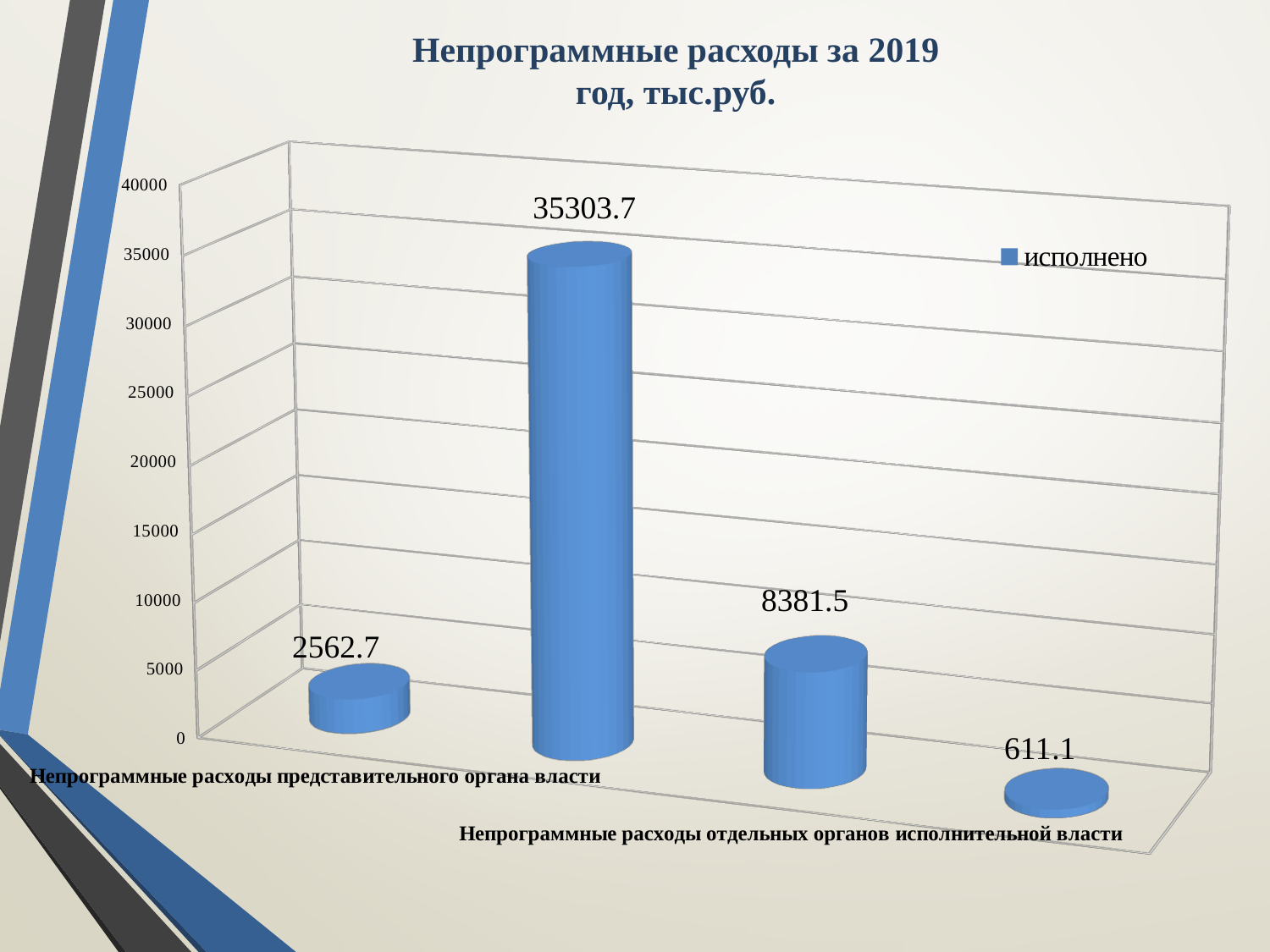
What is the name of the series in the legend? исполнено What is the value of the tallest bar in the chart? 35303.7 What is the value of the shortest bar in the chart? 611.1 What is the title of the chart? Непрограммные расходы за 2019 год, тыс.руб. Which is larger: the value for 'Непрограммные расходы представительного органа власти' or the value for 'Непрограммные расходы отдельных органов исполнительной власти'? Непрограммные расходы отдельных органов исполнительной власти What is the value for 'Непрограммные расходы представительного органа власти'? 2562.7 How many bars are plotted in the chart? 4 What is the value for 'Непрограммные расходы отдельных органов исполнительной власти'? 8381.5 How many series does the legend list? 1 What type of chart is shown on the slide? bar chart Is the value of the second bar from the left greater or less than 30000? greater What is the difference between the value for 'Непрограммные расходы отдельных органов исполнительной власти' and the value for 'Непрограммные расходы представительного органа власти'? 5818.8